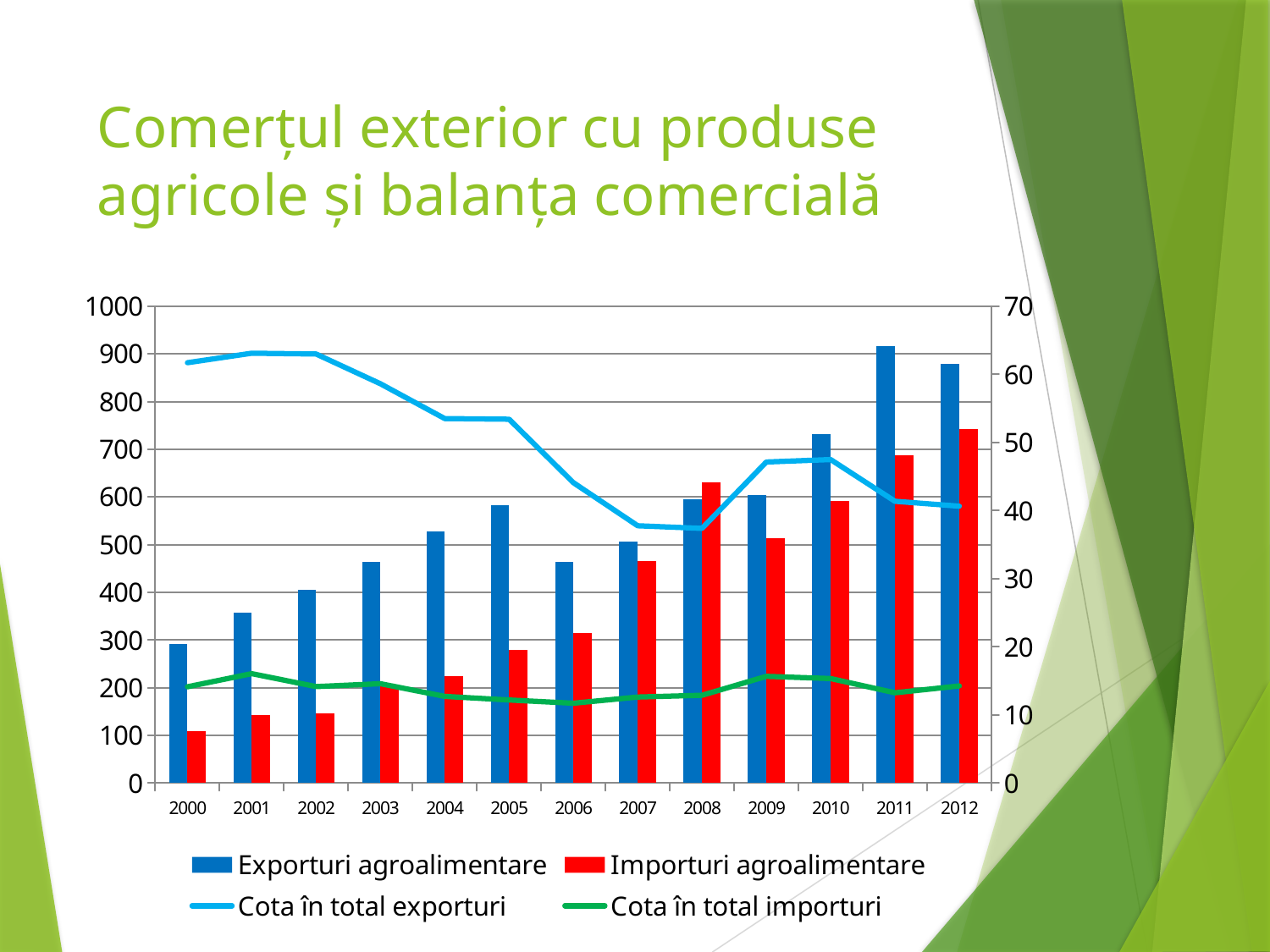
In which year is the Importuri agroalimentare bar the highest? 2012 Is the value for Cota în total importuri in 2006 greater or less than 20 on the right axis? less Does the Cota în total exporturi line rise or fall from 2002 to 2007? Fall In which year is the Exporturi agroalimentare bar the highest? 2011 In 2010, which is larger: Exporturi agroalimentare or Importuri agroalimentare? Exporturi agroalimentare Is the value for Importuri agroalimentare in 2012 greater or less than 700? greater In which year is the Exporturi agroalimentare bar the lowest? 2000 In which year is the Importuri agroalimentare bar the lowest? 2000 How many years are shown on the x axis of the chart? 13 How many series does the chart legend list? 4 Is the value for Exporturi agroalimentare in 2005 greater or less than 500? greater What kind of chart is shown on the slide? A combined bar and line chart